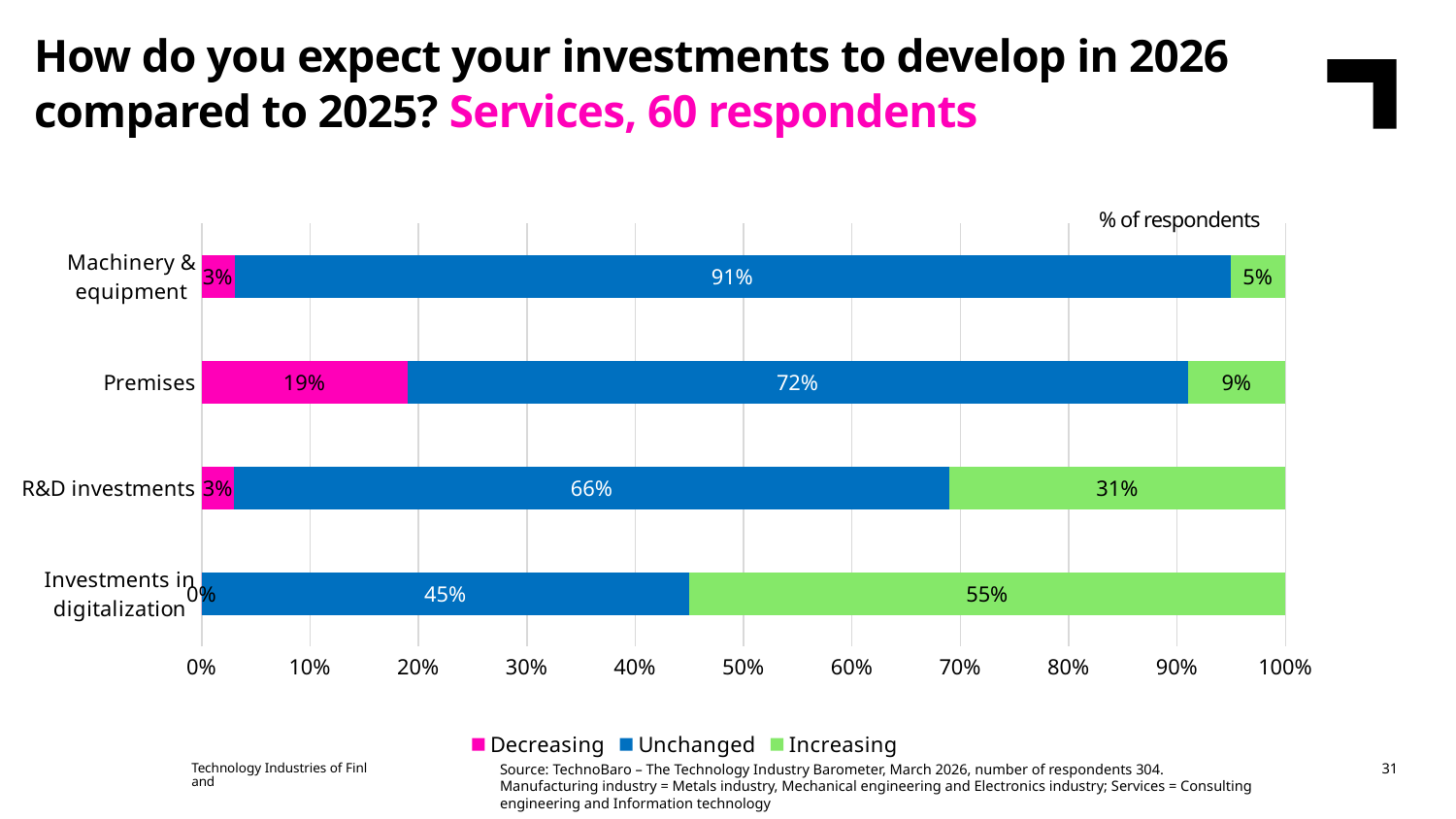
Which has a larger Decreasing share: Premises or Machinery & equipment? Premises What is the difference in percentage points between the Increasing share for Investments in digitalization and the Increasing share for R&D investments? 24 percentage points How many investment categories are shown in the chart? 4 Which investment category has the highest share of respondents expecting a decrease? Premises What type of chart is shown on the slide? Stacked bar chart What percentage of respondents expect R&D investments to increase? 31% What percentage of respondents expect Machinery & equipment investments to remain unchanged? 91% Which investment category has the lowest share of respondents expecting investments to remain unchanged? Investments in digitalization Which investment category has the highest share of respondents expecting an increase? Investments in digitalization What percentage of respondents expect Premises investments to remain unchanged? 72% How many series does the legend list? 3 What percentage of respondents expect Investments in digitalization to decrease? 0%